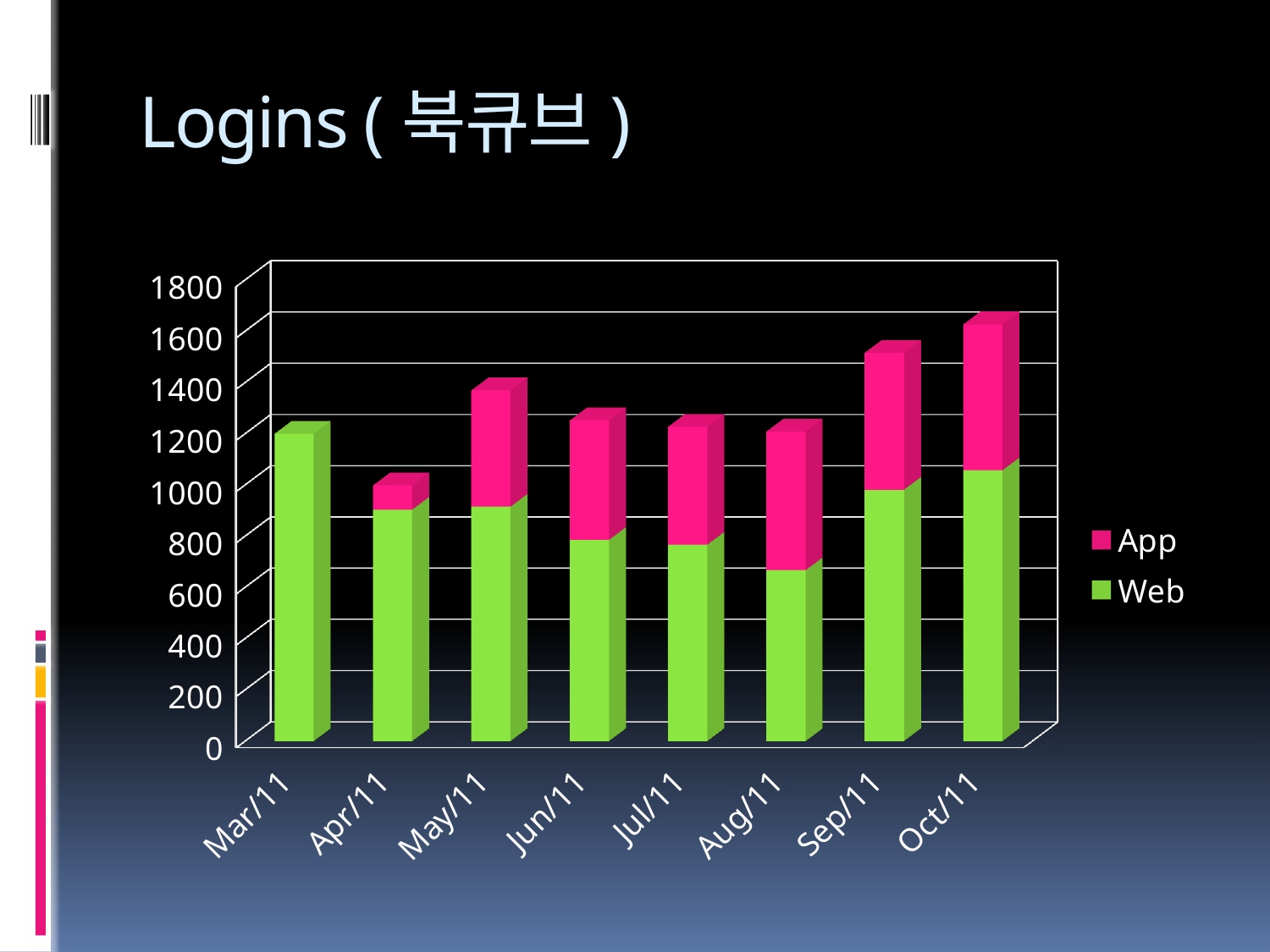
Which month has the larger total bar, Sep/11 or Jun/11? Sep/11 Is the Web value for Mar/11 greater or less than 1000? greater How many series does the legend list? 2 Which month has the tallest total bar? Oct/11 How many months (categories) are shown on the x axis? 8 Is the Web value for Aug/11 greater or less than 800? less What kind of chart is shown on the slide? Stacked bar chart Is the total bar for Oct/11 greater or less than 1400? greater Which series is shown in pink in the legend? App Which month has the lowest Web value? Aug/11 Which month has the shortest total bar? Apr/11 Which month has the highest Web value? Mar/11